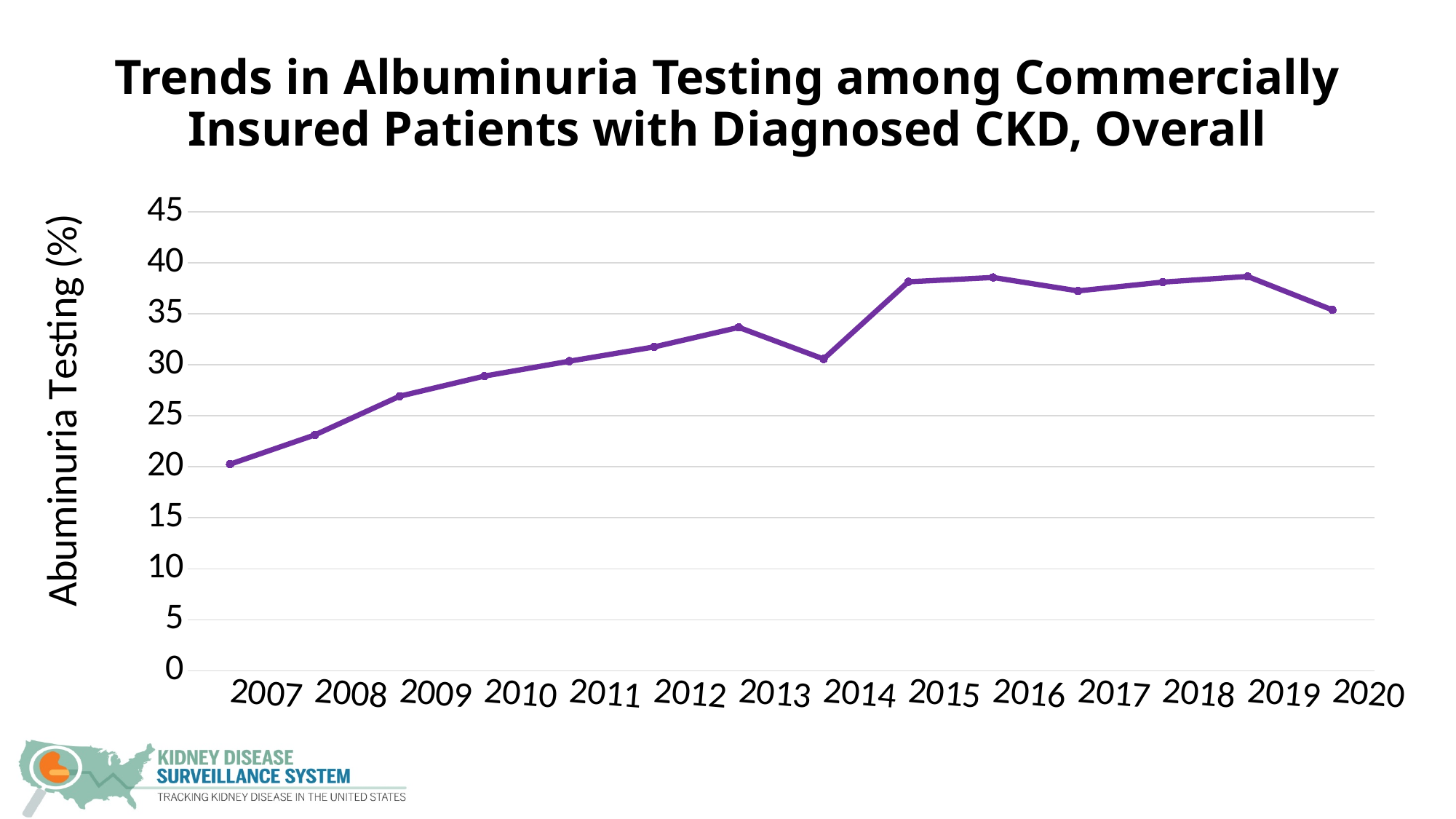
Which year has the higher albuminuria testing percentage, 2013 or 2014? 2013 Is the value for 2007 greater or less than 25? less Do the values rise or fall from 2007 to 2013? rise Which year has the higher albuminuria testing percentage, 2019 or 2020? 2019 What kind of chart is shown on the slide? line chart Is the value for 2015 greater or less than 35? greater Which year has the lowest albuminuria testing percentage? 2007 What is the label of the y axis? Abuminuria Testing (%) Is the value for 2009 greater or less than 25? greater How many years are plotted on the x axis? 14